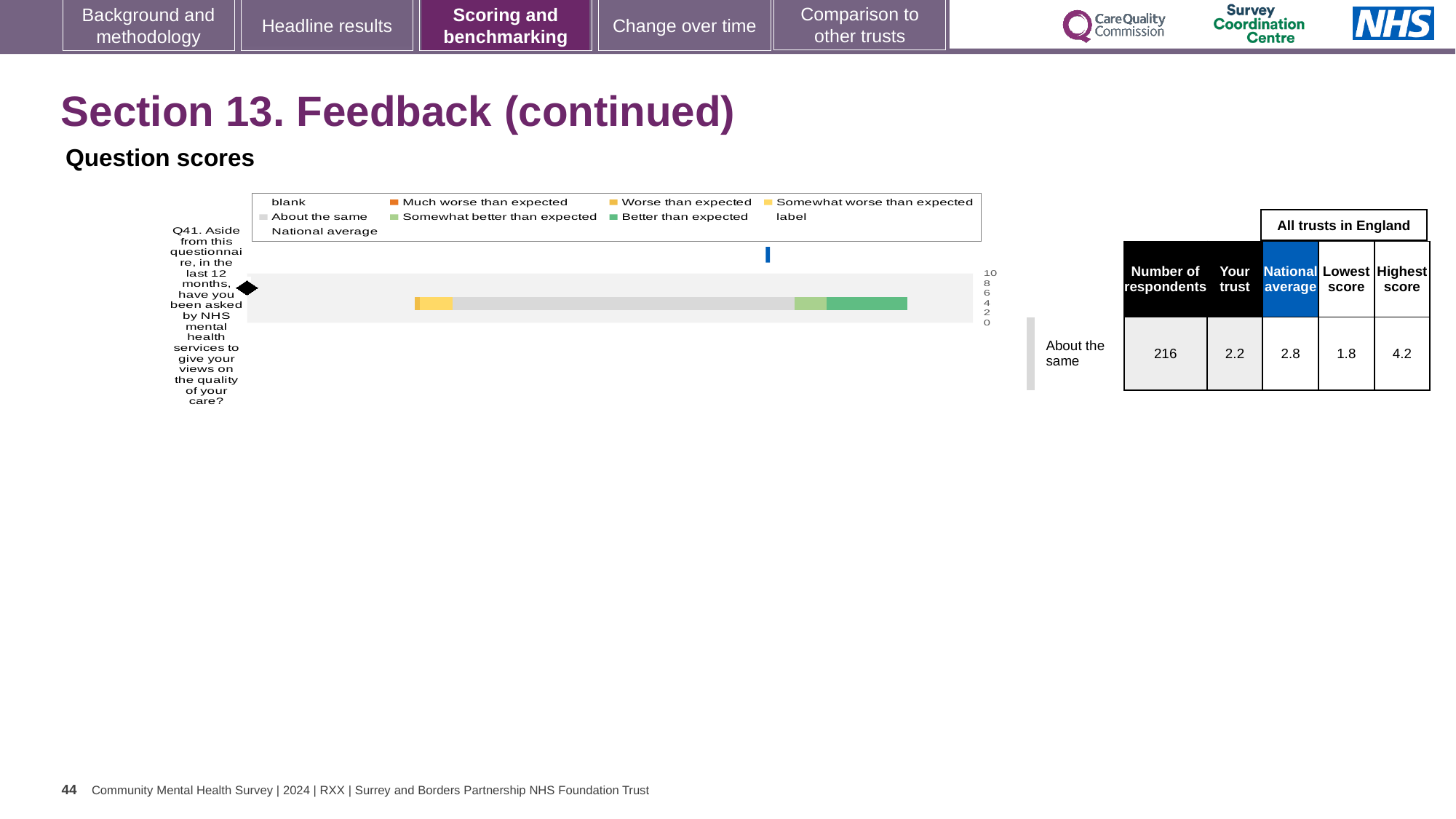
In the table beside the chart, what is the national average score for Q41? 2.8 Which legend entry is shown in dark green in the chart? Better than expected Which question number is plotted in the chart? Q41 According to the table beside the chart, is the 'Your trust' score for Q41 higher or lower than the national average? lower In the table beside the chart, what is the number of respondents for Q41? 216 What is the difference between the highest score and the lowest score for Q41 in the table beside the chart? 2.4 What kind of chart is shown on the slide? bar chart How many entries does the chart's legend list? 9 In the table beside the chart, what is the 'Your trust' score for Q41? 2.2 In the table beside the chart, what is the lowest score among all trusts in England for Q41? 1.8 In the table beside the chart, what is the highest score among all trusts in England for Q41? 4.2 How many questions (categories) are plotted in the chart? 1